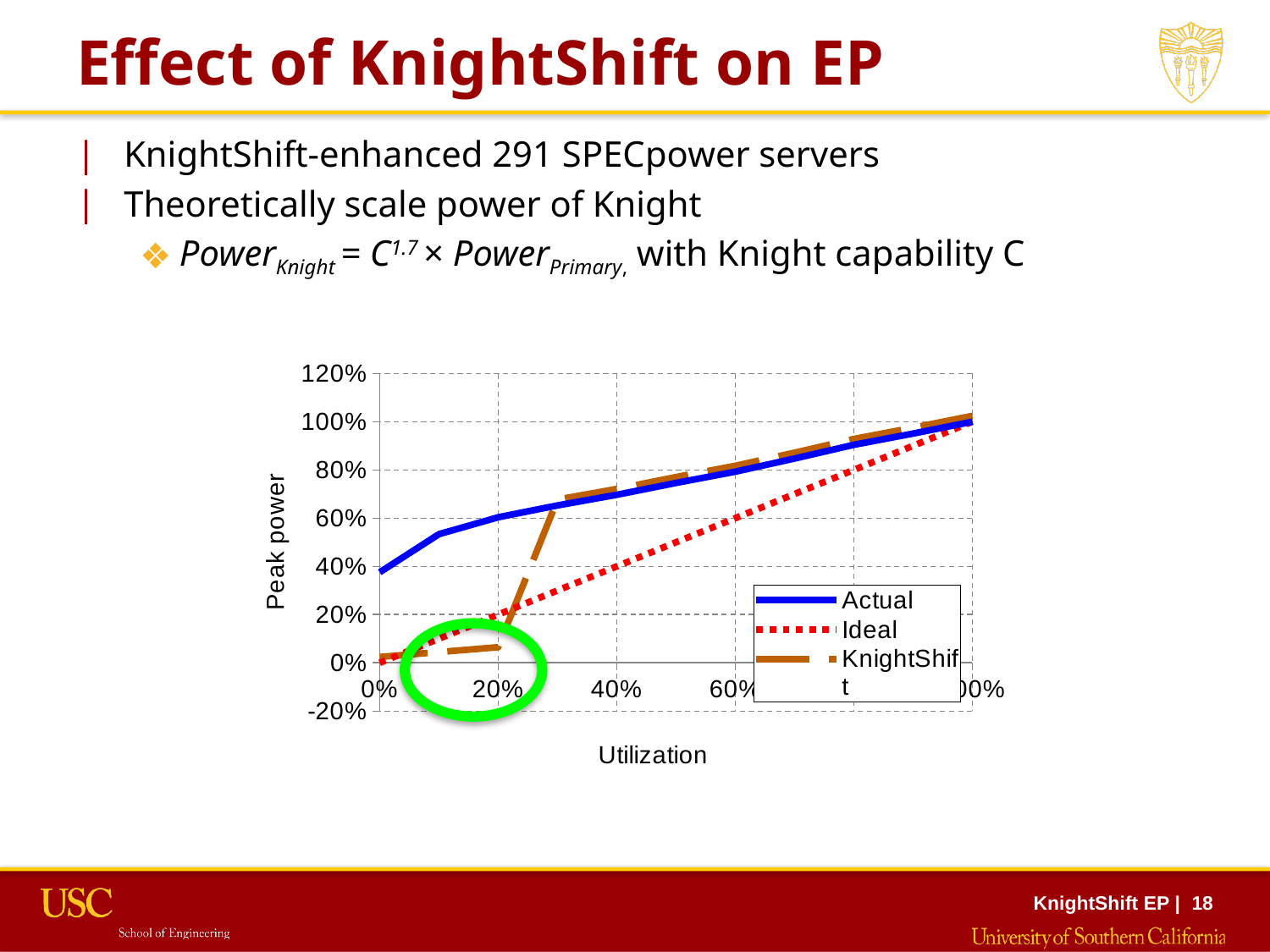
Is the Actual peak power at 0% utilization greater or less than 20%? greater What are the names of the series listed in the chart's legend? Actual, Ideal, KnightShift Which series has the highest peak power at 0% utilization? Actual How many series does the chart's legend list? 3 What kind of chart is shown on the slide? line chart Does the Actual series rise or fall as Utilization increases from 0% to 100%? rise What is the label of the chart's vertical axis? Peak power At 20% utilization, which series has the higher peak power, Actual or KnightShift? Actual At 60% utilization, which series has the higher peak power, Actual or Ideal? Actual Is the KnightShift peak power at 20% utilization greater or less than 20%? less Is the Actual peak power at 20% utilization greater or less than 40%? greater Does the Ideal series rise or fall as Utilization increases? rise